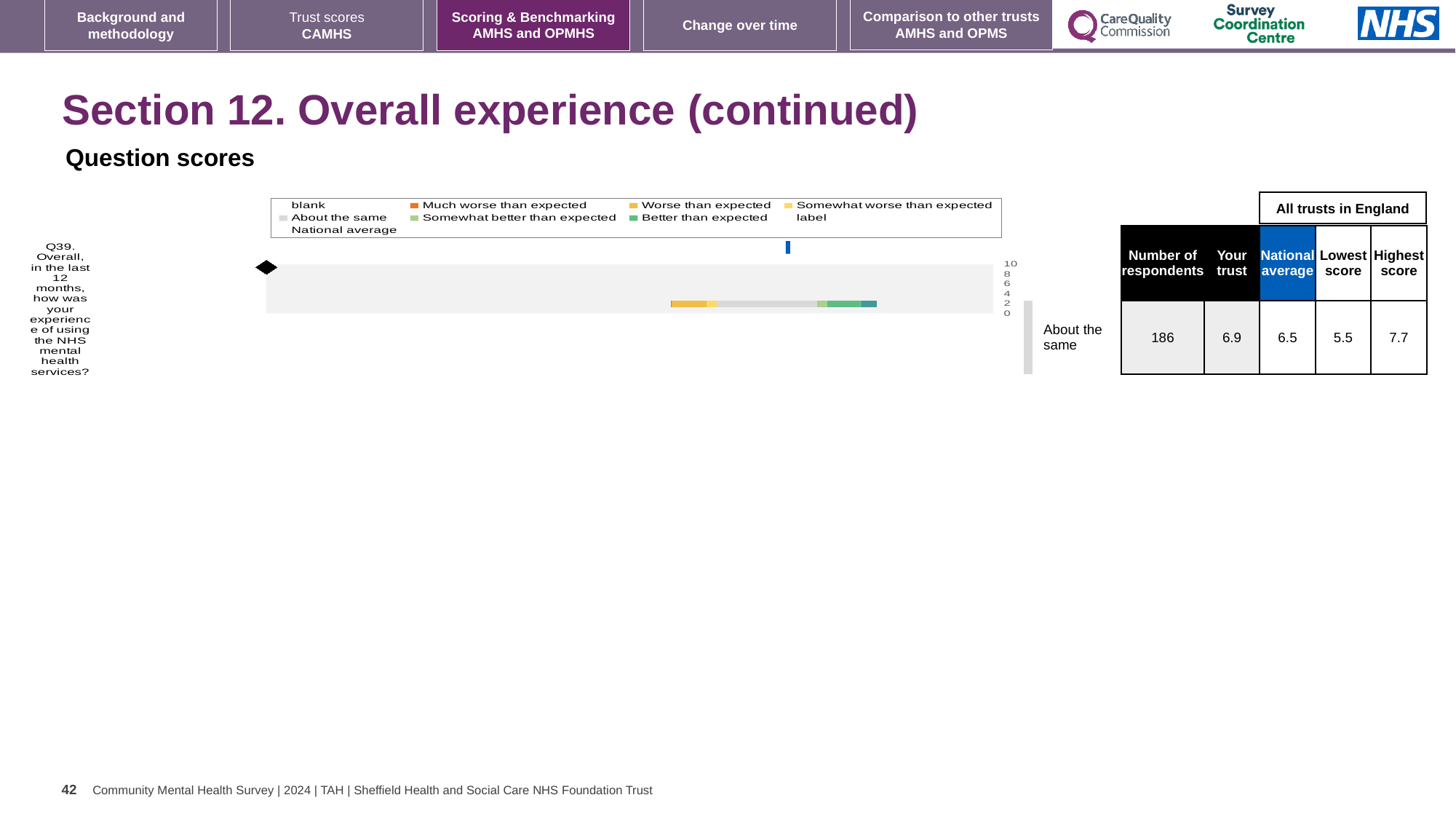
In the table next to the chart, what is the lowest score among all trusts in England for Q39? 5.5 What is the maximum value shown on the chart's score axis? 10 In the table next to the chart, what is the national average score for Q39? 6.5 Which is larger for Q39, the 'Your trust' score or the national average? Your trust In the table next to the chart, what is the highest score among all trusts in England for Q39? 7.7 In the table next to the chart, what is the score for 'Your trust' for Q39? 6.9 What kind of chart is shown on the slide for Q39? bar chart How many survey questions are plotted in the chart? 1 Which question number is plotted in the chart? Q39 What benchmark category label is shown to the right of the chart for Q39? About the same How many respondents answered Q39 according to the table next to the chart? 186 What is the difference between the highest score and the lowest score for Q39 in the table? 2.2